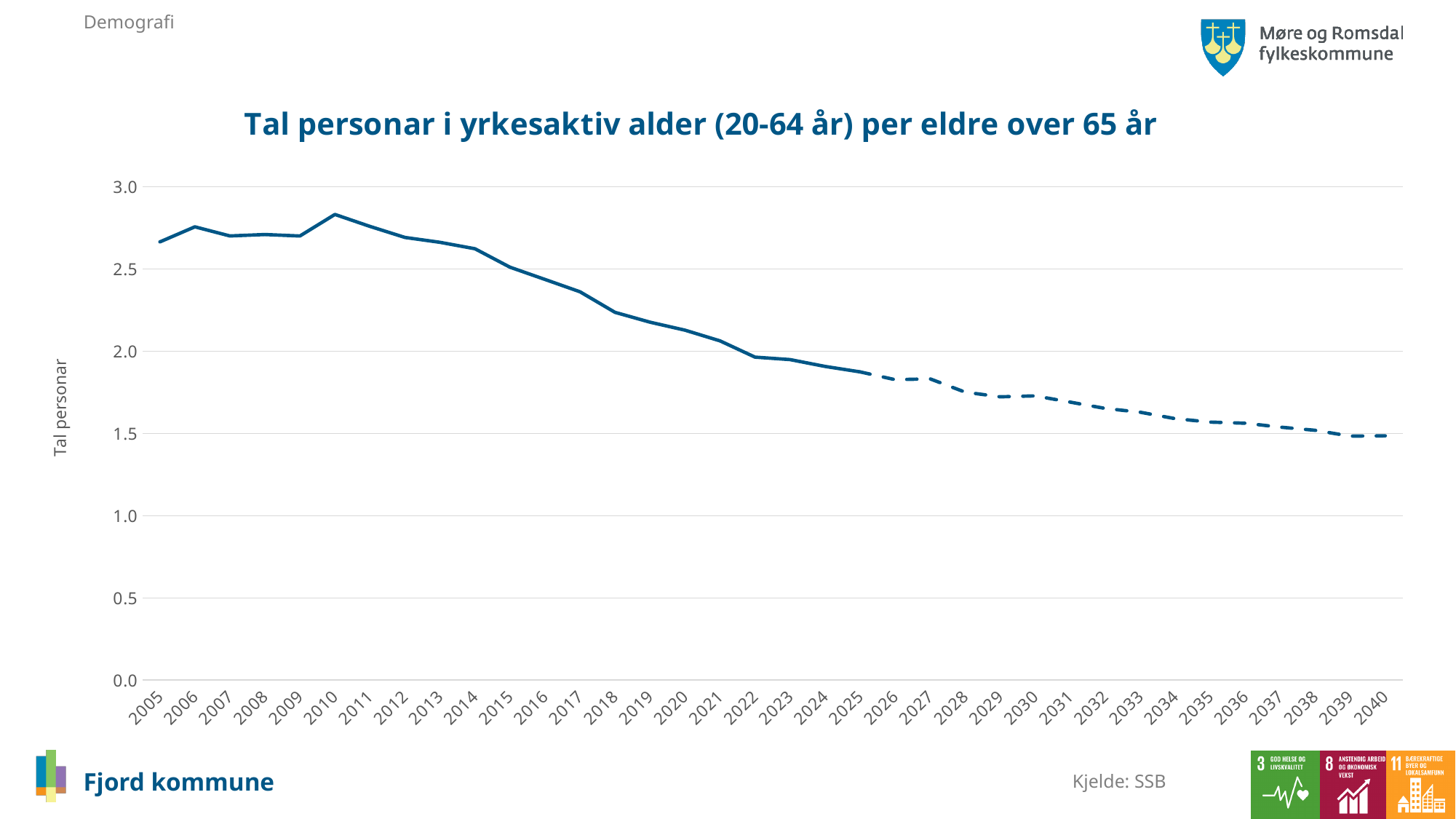
What kind of chart is shown on the slide? line chart How many years are shown along the x axis of the chart? 36 Which year has the larger value, 2005 or 2040? 2005 Is the value for 2040 greater or less than 2.0? less Is the value for 2018 greater or less than 2.0? greater In which year is the value highest? 2010 Is the value for 2010 greater or less than 2.5? greater What is the label on the vertical axis of the chart? Tal personar What is the title of the chart? Tal personar i yrkesaktiv alder (20-64 år) per eldre over 65 år Do the values generally rise or fall from 2010 to 2040? fall